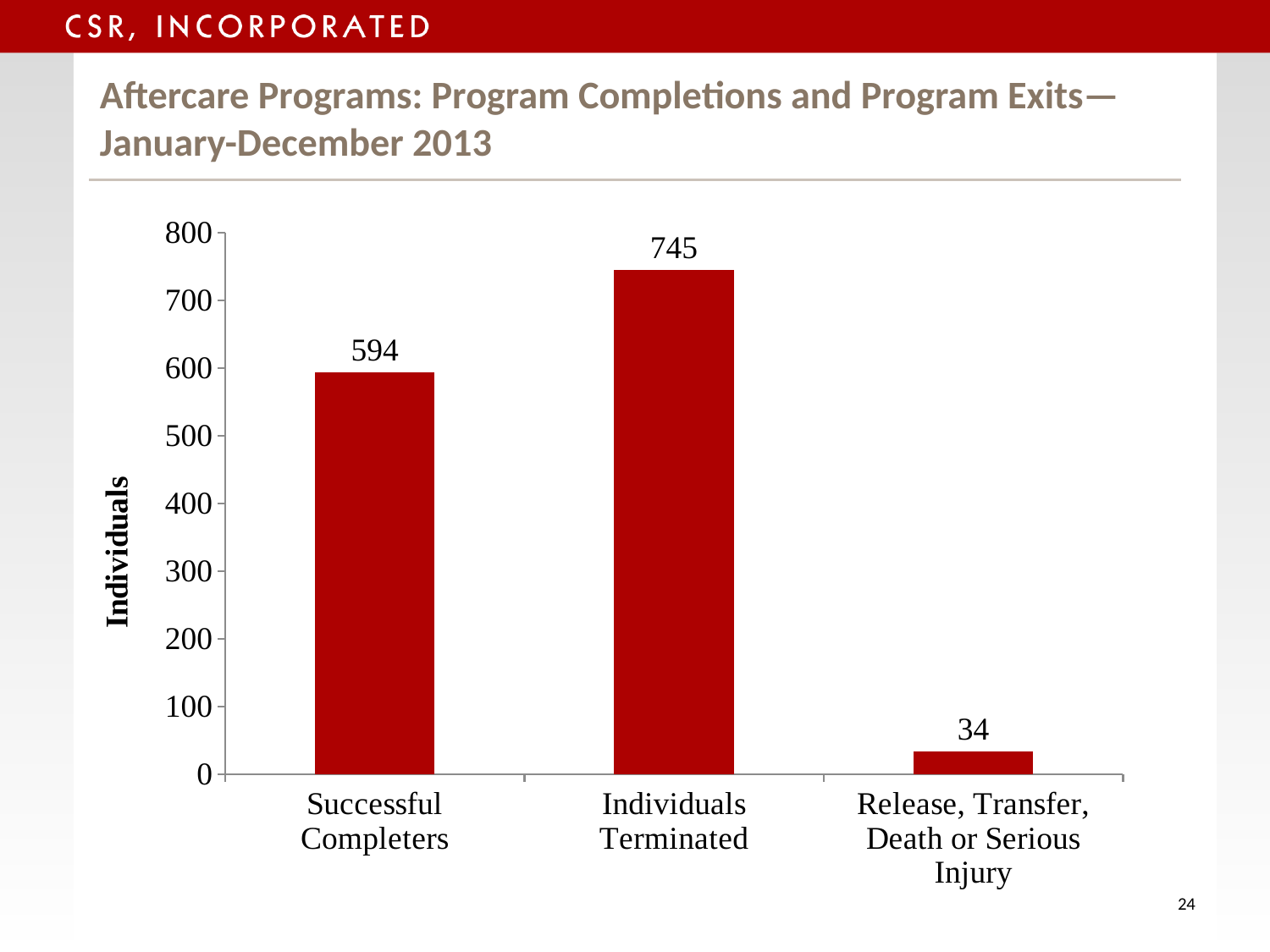
What is the value for Release, Transfer, Death or Serious Injury? 34 How many categories are shown on the x axis? 3 Which category has the highest value? Individuals Terminated What kind of chart is shown on the slide? bar chart What is the label of the vertical axis? Individuals What is the difference between Individuals Terminated and Successful Completers? 151 Which category has the lowest value? Release, Transfer, Death or Serious Injury Is the value for Successful Completers greater or less than 500? greater What is the value for Successful Completers? 594 What is the value for Individuals Terminated? 745 What is the difference between Successful Completers and Release, Transfer, Death or Serious Injury? 560 Which is larger, Successful Completers or Individuals Terminated? Individuals Terminated